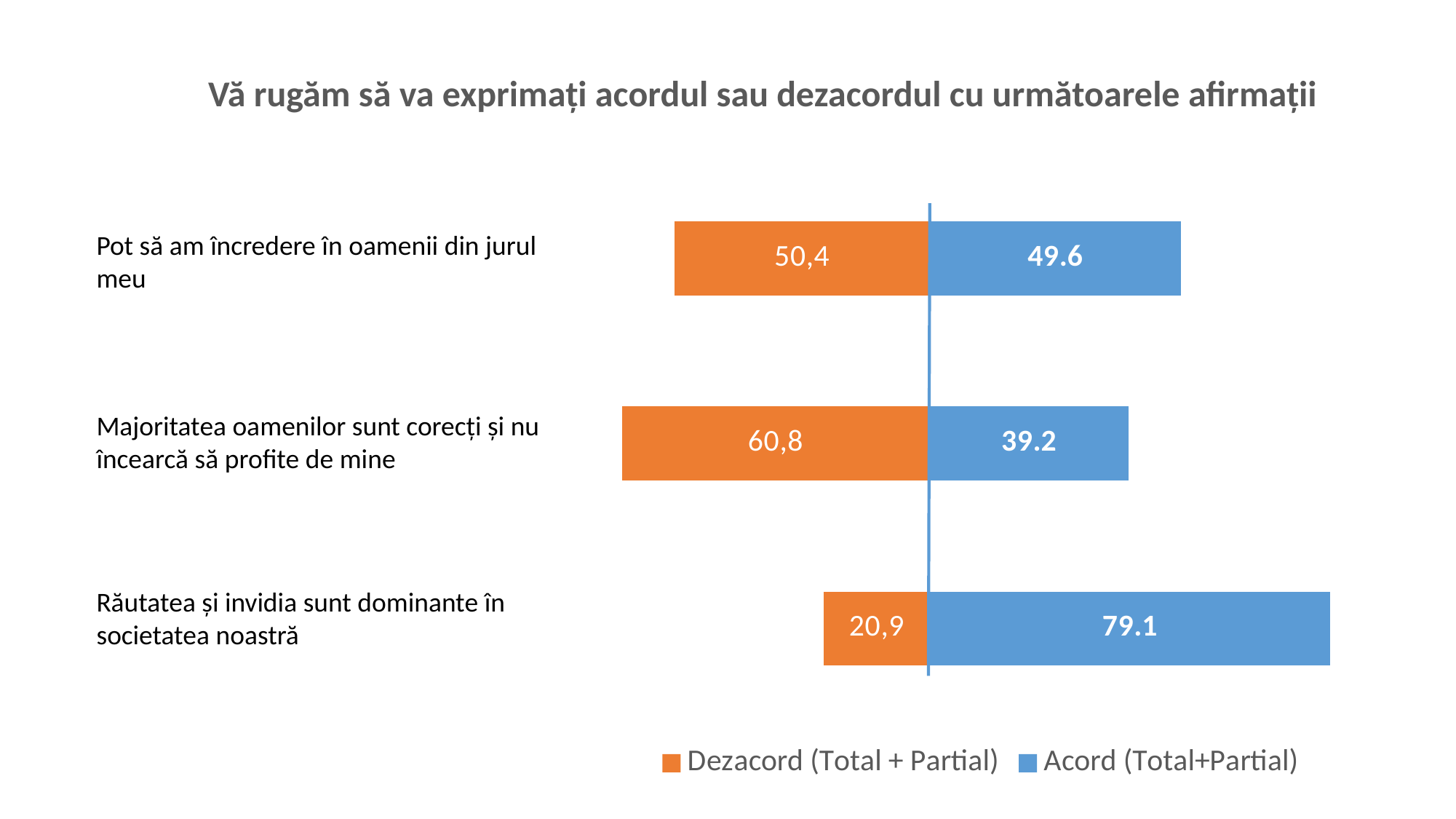
Which statement has the highest Dezacord (Total + Partial) value? Majoritatea oamenilor sunt corecți și nu încearcă să profite de mine How many statements (categories) are shown in the chart? 3 For "Majoritatea oamenilor sunt corecți și nu încearcă să profite de mine", which is larger: Dezacord (Total + Partial) or Acord (Total+Partial)? Dezacord (Total + Partial) What is the Dezacord (Total + Partial) value for "Răutatea și invidia sunt dominante în societatea noastră"? 20,9 Which statement has the highest Acord (Total+Partial) value? Răutatea și invidia sunt dominante în societatea noastră How many series does the legend list? 2 What is the Acord (Total+Partial) value for "Răutatea și invidia sunt dominante în societatea noastră"? 79.1 Which statement has the lowest Dezacord (Total + Partial) value? Răutatea și invidia sunt dominante în societatea noastră What is the Dezacord (Total + Partial) value for "Pot să am încredere în oamenii din jurul meu"? 50,4 What type of chart is shown on the slide? Bar chart What is the Acord (Total+Partial) value for "Majoritatea oamenilor sunt corecți și nu încearcă să profite de mine"? 39.2 What is the difference between the Acord (Total+Partial) values for "Răutatea și invidia sunt dominante în societatea noastră" and "Majoritatea oamenilor sunt corecți și nu încearcă să profite de mine"? 39.9